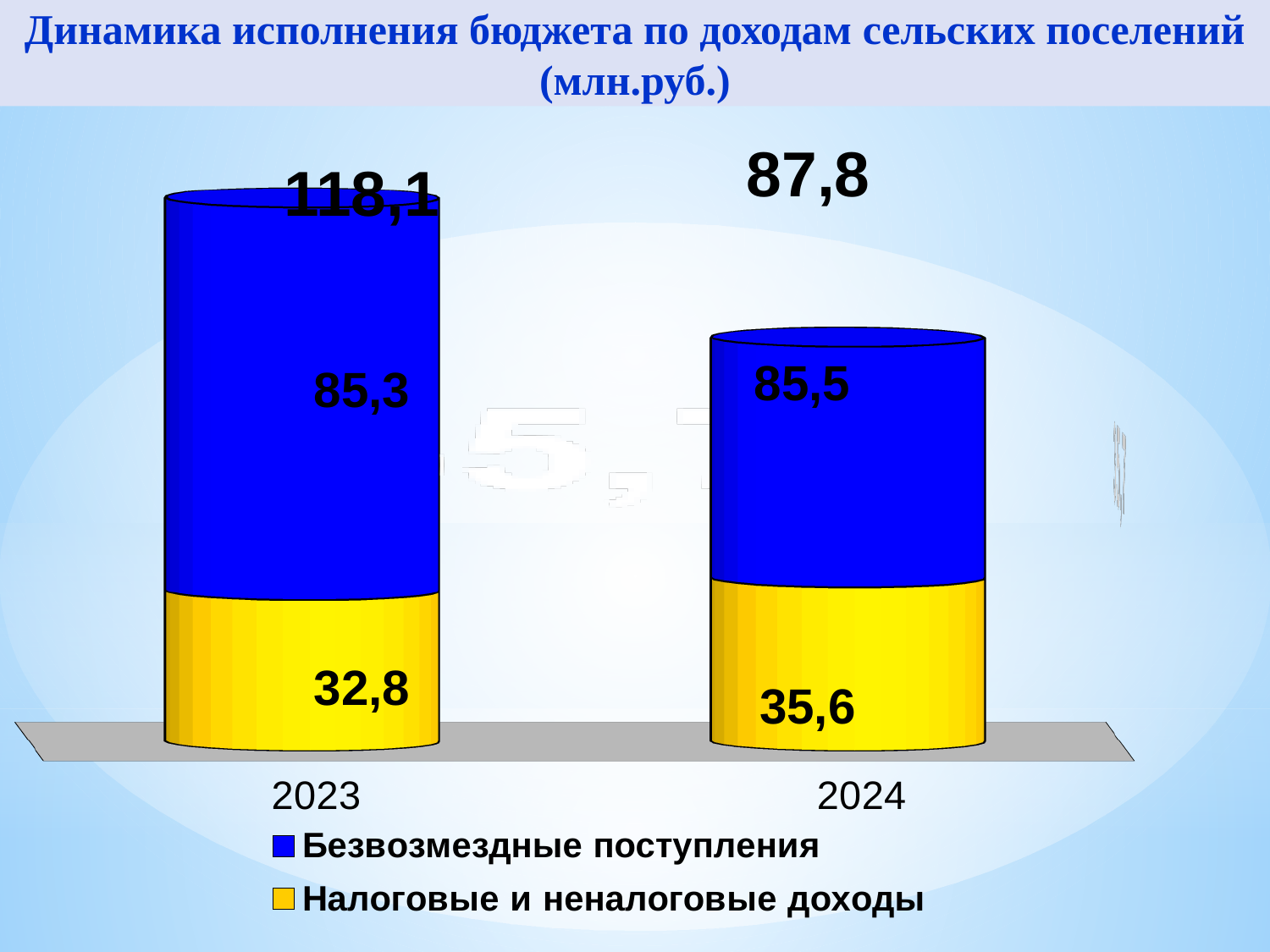
What is the total of the stacked bar for 2023? 118,1 What is the value of Безвозмездные поступления for 2023? 85,3 Which year has the larger value for Налоговые и неналоговые доходы, 2023 or 2024? 2024 How many series does the legend list? 2 What kind of chart is shown on the slide? Stacked bar chart Do the values for Налоговые и неналоговые доходы rise or fall from 2023 to 2024? Rise What is the value of Налоговые и неналоговые доходы for 2023? 32,8 How many years are shown on the x axis? 2 By how much did Налоговые и неналоговые доходы change from 2023 to 2024? 2,8 What is the value of Налоговые и неналоговые доходы for 2024? 35,6 Which colour represents Безвозмездные поступления in the chart? Blue